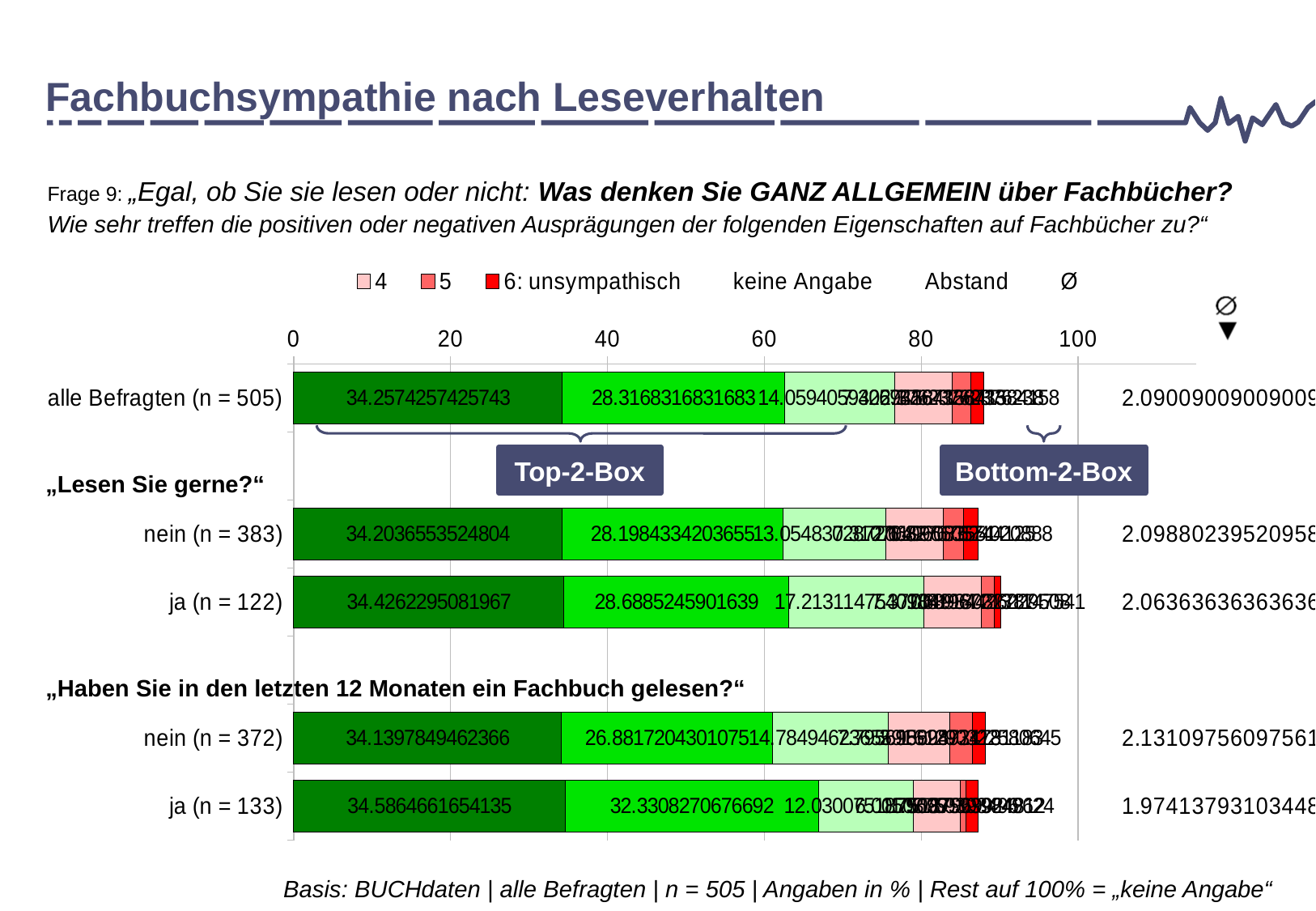
What is the value of the second (bright green) segment of the bar for "nein (n = 383)"? 28.1984334203655 Is the total length of the bar for "ja (n = 122)" greater or less than 100? less What kind of chart is shown on the slide? bar chart Is the total length of the bar for "alle Befragten (n = 505)" greater or less than 80? greater What is the value of the leftmost (dark green) segment of the bar for "nein (n = 372)"? 34.1397849462366 How many categories (bars) are plotted in the chart? 5 What is the value of the leftmost (dark green) segment of the bar for "alle Befragten (n = 505)"? 34.2574257425743 What is the value of the second (bright green) segment of the bar for "ja (n = 133)"? 32.3308270676692 What is the difference between the second (bright green) segment for "ja (n = 133)" and for "nein (n = 372)"? 5.4491066375617 What is the title of the slide containing the chart? Fachbuchsympathie nach Leseverhalten Which category has the largest second (bright green) segment? ja (n = 133) Which is larger: the second (bright green) segment for "nein (n = 372)" or for "ja (n = 133)"? ja (n = 133)